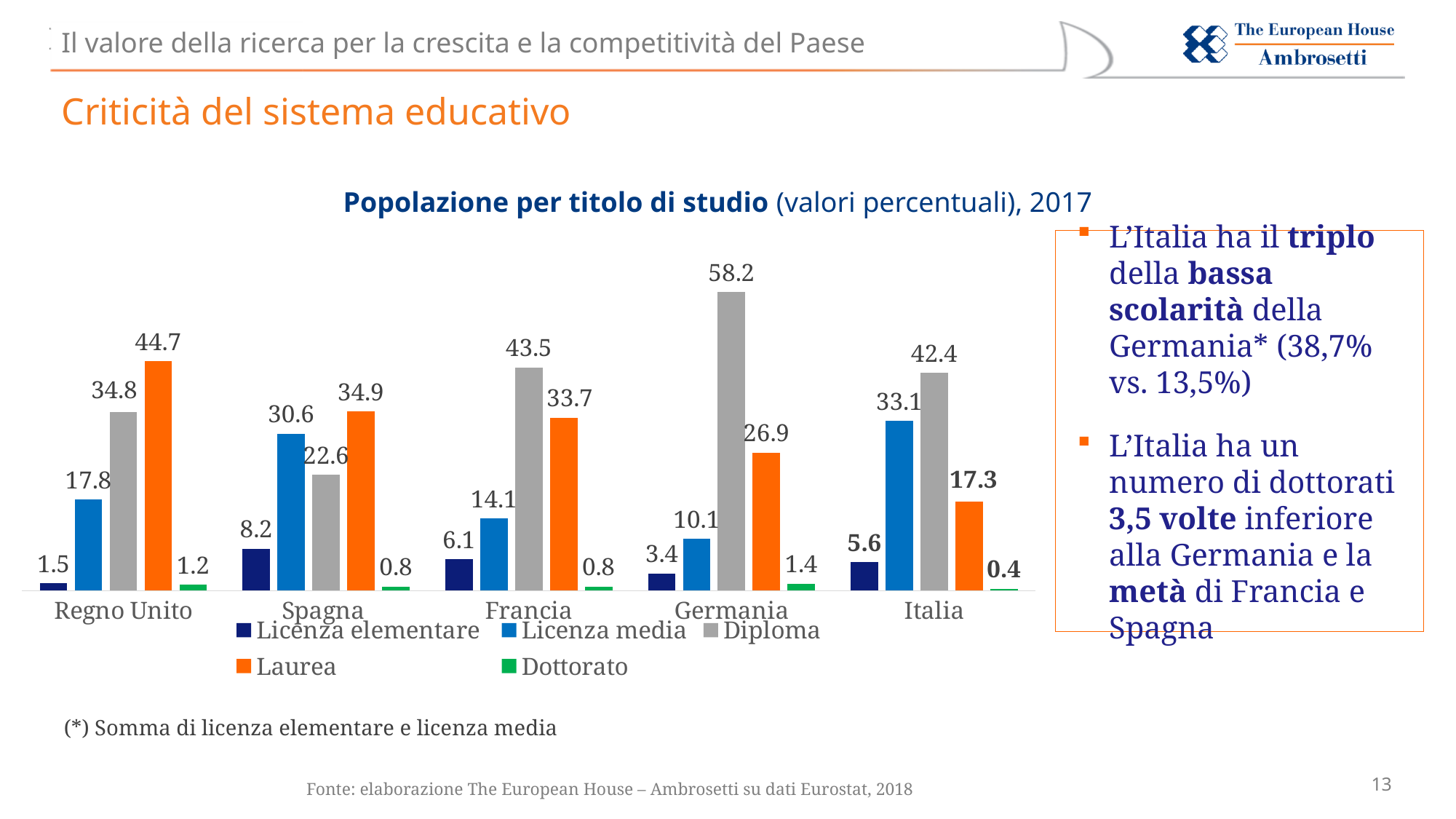
How many series does the legend list? 5 How many countries are shown on the x axis? 5 What is the sum of the Licenza elementare and Licenza media values for Italia? 38.7 What kind of chart is shown on the slide? Bar chart What is the difference between the Diploma values for Germania and Italia? 15.8 Which is larger, the Licenza media value for Italia or for Francia? Italia What is the Diploma value for Germania? 58.2 What is the Laurea value for Italia? 17.3 Which country has the highest Laurea value? Regno Unito What is the Dottorato value for Regno Unito? 1.2 Which country has the lowest Dottorato value? Italia What is the Licenza media value for Spagna? 30.6